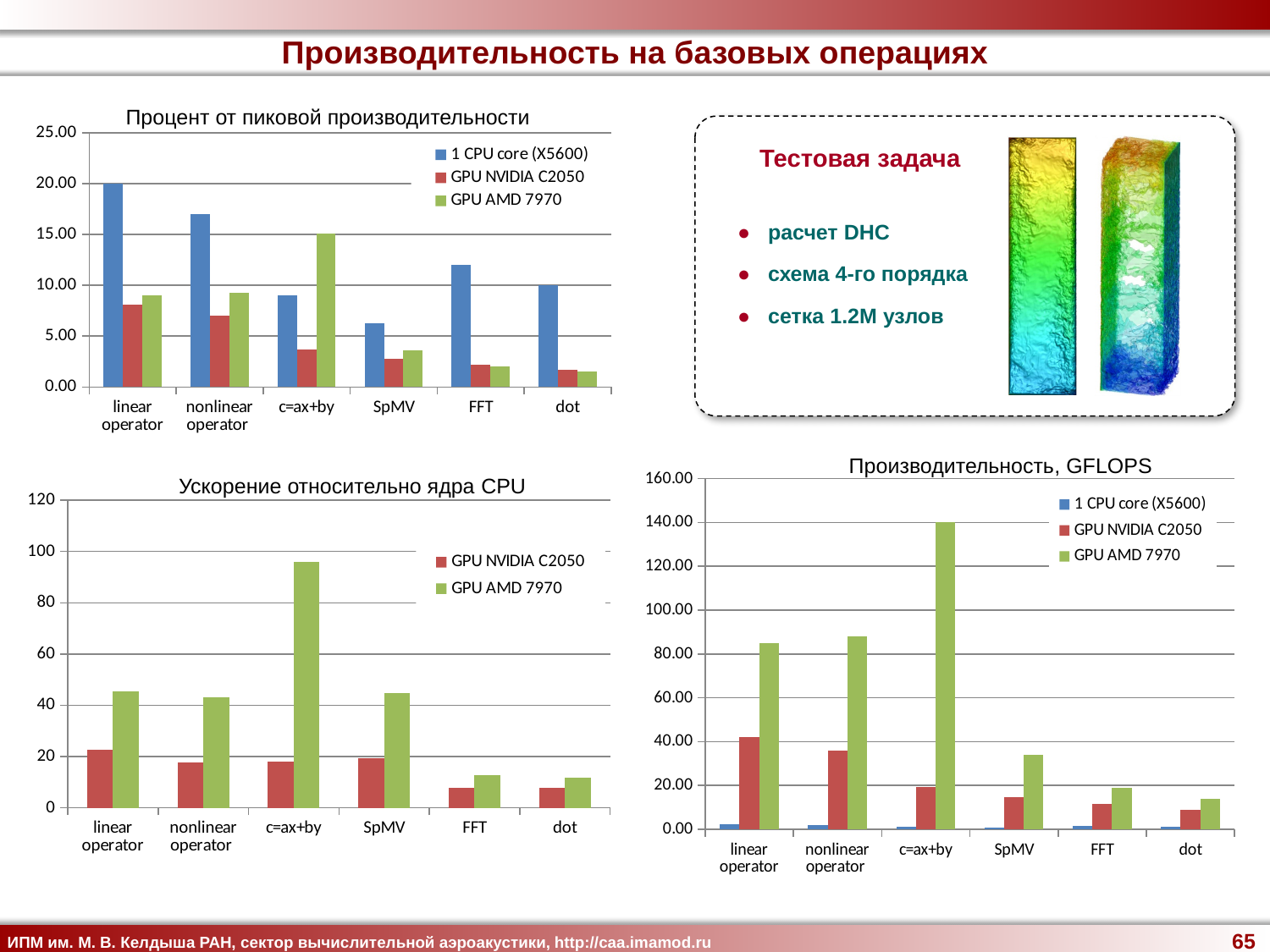
In the chart titled "Процент от пиковой производительности", which is larger for SpMV: 1 CPU core (X5600) or GPU NVIDIA C2050? 1 CPU core (X5600) In the chart titled "Производительность, GFLOPS", is the value for GPU NVIDIA C2050 at linear operator greater or less than 20.00? greater In the chart titled "Ускорение относительно ядра CPU", is the value for GPU AMD 7970 at c=ax+by greater or less than 80? greater In the chart titled "Производительность, GFLOPS", which is larger for FFT: GPU NVIDIA C2050 or GPU AMD 7970? GPU AMD 7970 In the chart titled "Ускорение относительно ядра CPU", how many categories are shown on the x axis? 6 In the chart titled "Процент от пиковой производительности", is the value for GPU AMD 7970 at c=ax+by greater or less than 10.00? greater What kind of chart is the one titled "Производительность, GFLOPS"? bar chart In the chart titled "Ускорение относительно ядра CPU", which category has the highest value for GPU AMD 7970? c=ax+by In the chart titled "Ускорение относительно ядра CPU", how many series does the legend list? 2 In the chart titled "Производительность, GFLOPS", which category has the highest value for GPU AMD 7970? c=ax+by In the chart titled "Процент от пиковой производительности", which category has the highest value for the 1 CPU core (X5600) series? linear operator In the chart titled "Процент от пиковой производительности", how many series does the legend list? 3